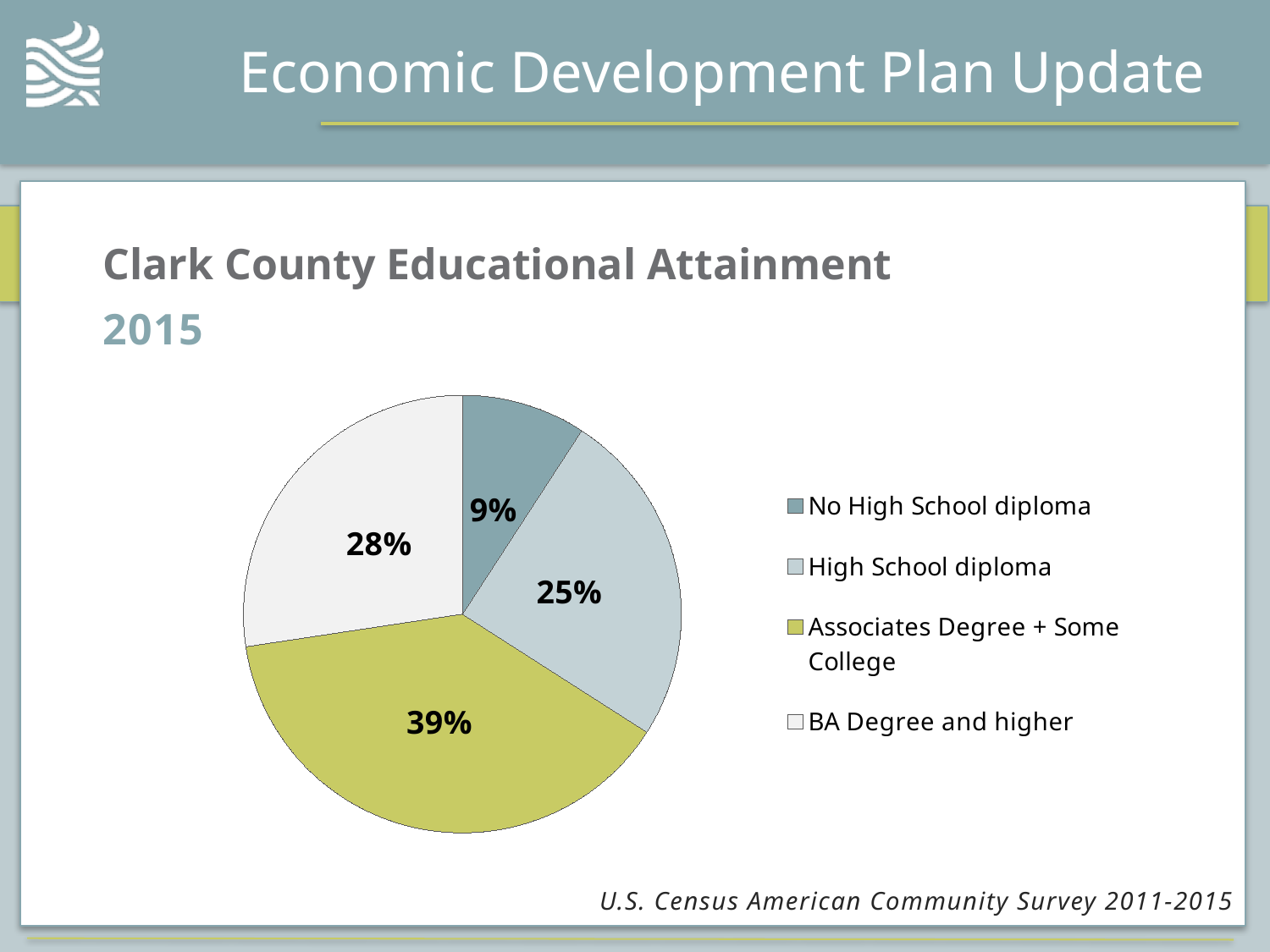
What data source is cited below the chart? U.S. Census American Community Survey 2011-2015 What share of the pie is labelled for High School diploma? 25% What share of the pie is labelled for No High School diploma? 9% What share of the pie is labelled for BA Degree and higher? 28% What is the title of the chart? Clark County Educational Attainment 2015 Which is larger, the slice for BA Degree and higher or the slice for High School diploma? BA Degree and higher How many categories does the pie chart show? 4 What is the difference in percentage points between the BA Degree and higher slice and the High School diploma slice? 3% What kind of chart is shown on the slide? Pie chart Which category has the largest slice of the pie? Associates Degree + Some College Which category has the smallest slice of the pie? No High School diploma